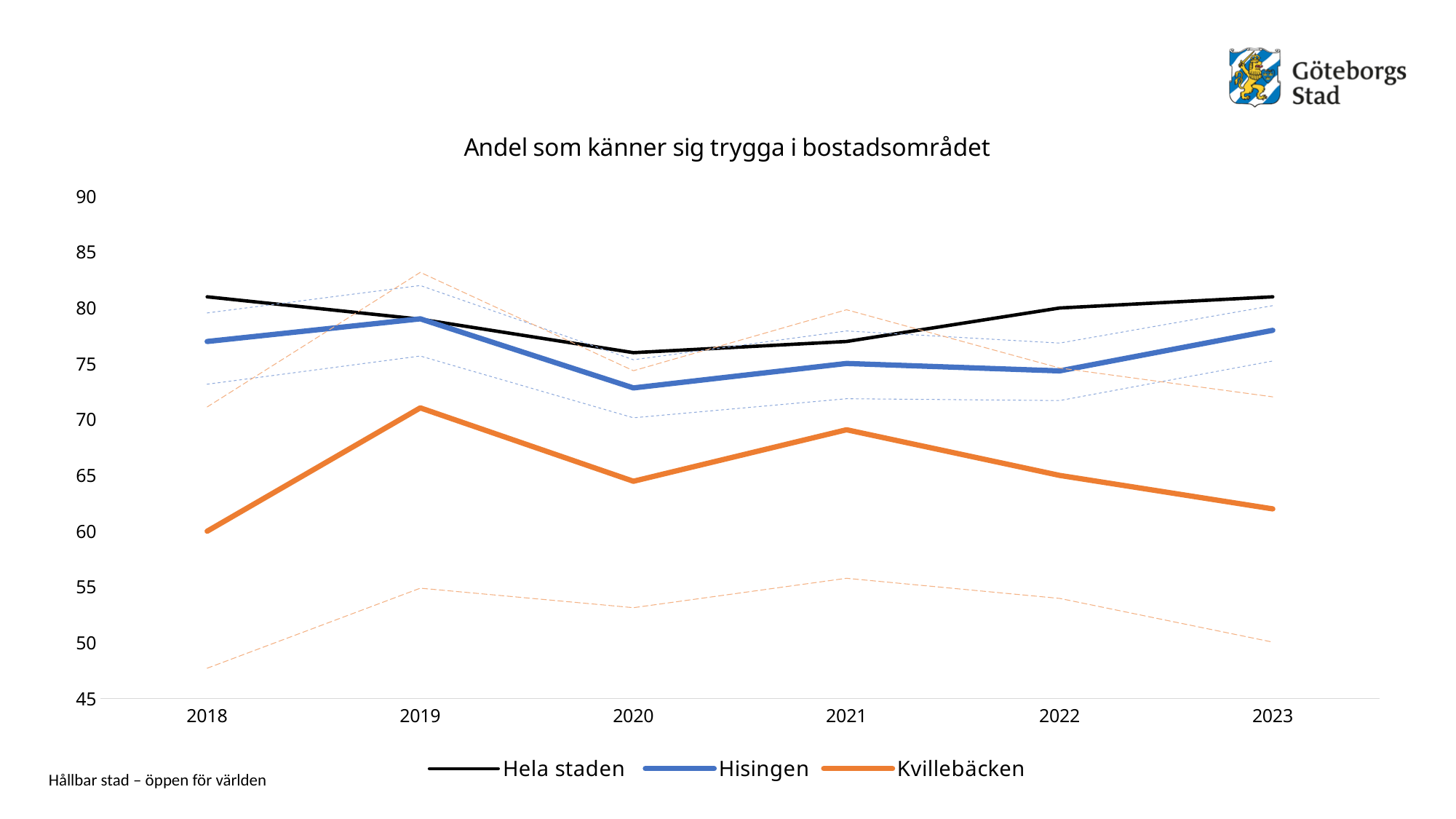
In which year is the value for Kvillebäcken highest? 2019 Does the value for Kvillebäcken rise or fall from 2021 to 2023? fall Is the value for Hisingen in 2020 greater or less than 75? less How many years are shown on the x axis? 6 What kind of chart is shown on the slide? line chart In which year is the value for Hisingen lowest? 2020 How many series does the legend list? 3 In which year is the value for Kvillebäcken lowest? 2018 Is the value for Kvillebäcken in 2023 greater or less than 65? less Is the value for Hela staden in 2020 greater or less than 75? greater Which is larger in 2023, the value for Hela staden or the value for Kvillebäcken? Hela staden What is the title of the chart? Andel som känner sig trygga i bostadsområdet